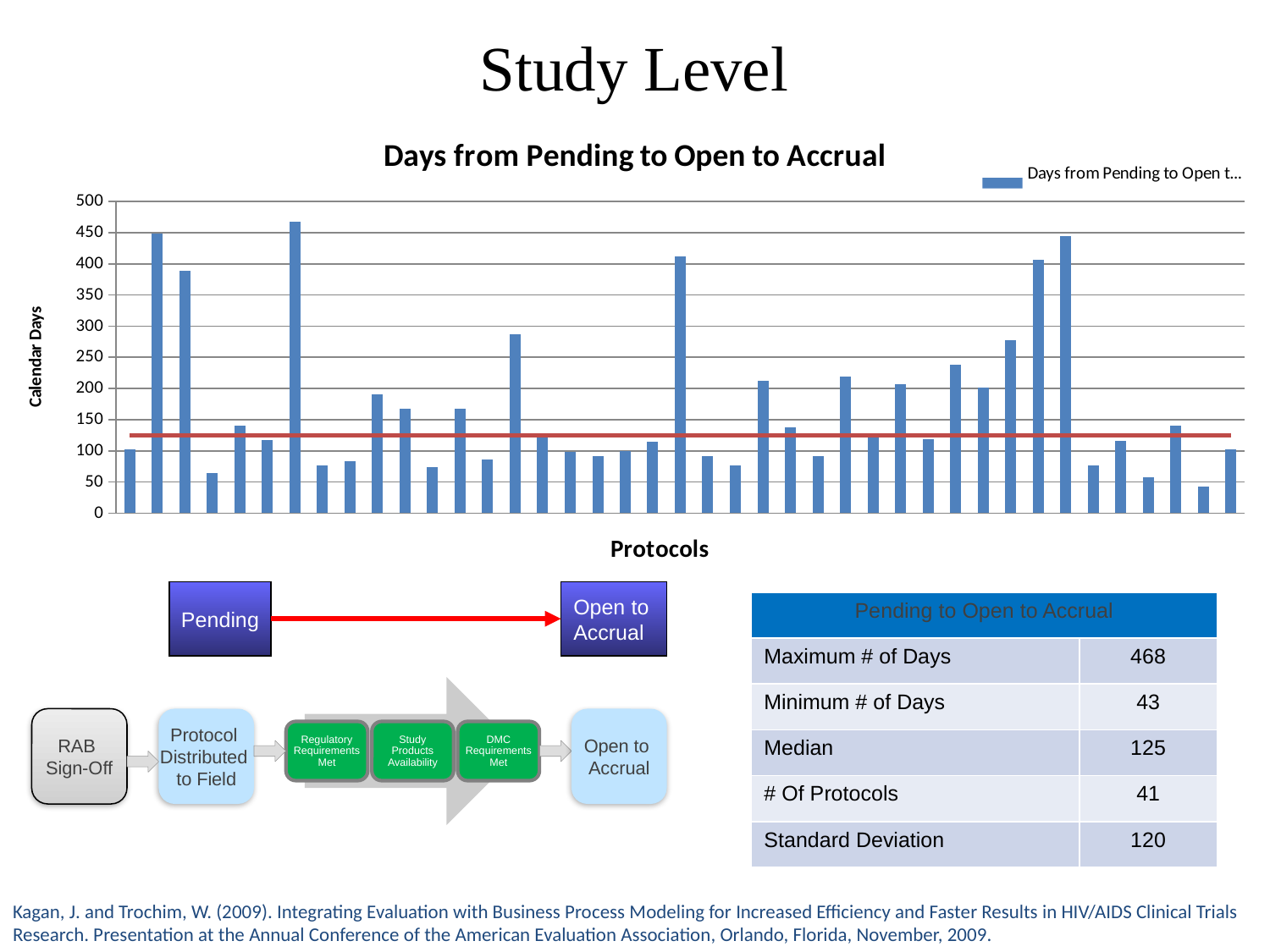
Is the red horizontal line in the chart above or below 100 on the vertical axis? above What is the title of the chart? Days from Pending to Open to Accrual How many protocols are plotted in the chart? 41 Is the value of the shortest bar in the chart greater or less than 50? less What is the highest tick value shown on the vertical axis of the chart? 500 How many series does the chart's legend list? 1 What kind of chart is shown on the slide? bar chart What is the maximum number of days plotted in the chart? 468 What is the minimum number of days plotted in the chart? 43 Is the value of the tallest bar in the chart greater or less than 450? greater What is the label on the vertical axis of the chart? Calendar Days